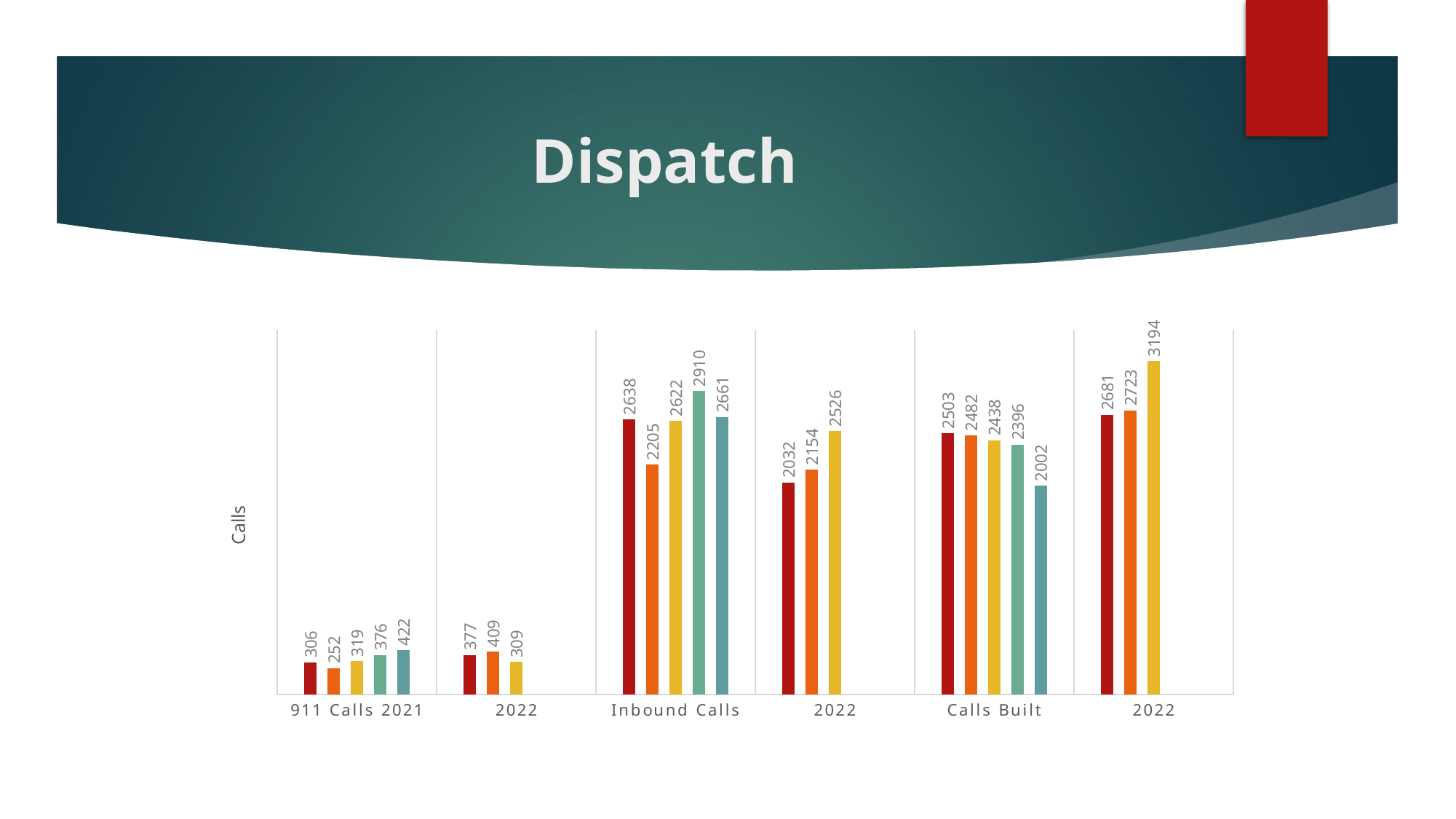
How many category groups are shown along the x axis of the chart? 6 What kind of chart is shown on the slide? bar chart Which is larger: the teal bar in the 911 Calls 2021 group (422) or the dark red bar in the 2022 group next to it (377)? 422 What is the title of the vertical axis of the chart? Calls What is the value of the last (teal) bar in the Calls Built group? 2002 How many bars are in the 2022 group immediately to the right of 911 Calls 2021? 3 What is the value of the first (dark red) bar in the Inbound Calls group? 2638 What is the lowest value labelled in the chart? 252 What is the difference between the yellow bar (3194) and the dark red bar (2681) in the 2022 group next to Calls Built? 513 What is the value of the tallest bar in the chart (the yellow bar in the 2022 group next to Calls Built)? 3194 What is the difference between the highest bar (2910) and the lowest bar (2205) in the Inbound Calls group? 705 What is the value of the first (dark red) bar in the 2022 group immediately to the right of Inbound Calls? 2032